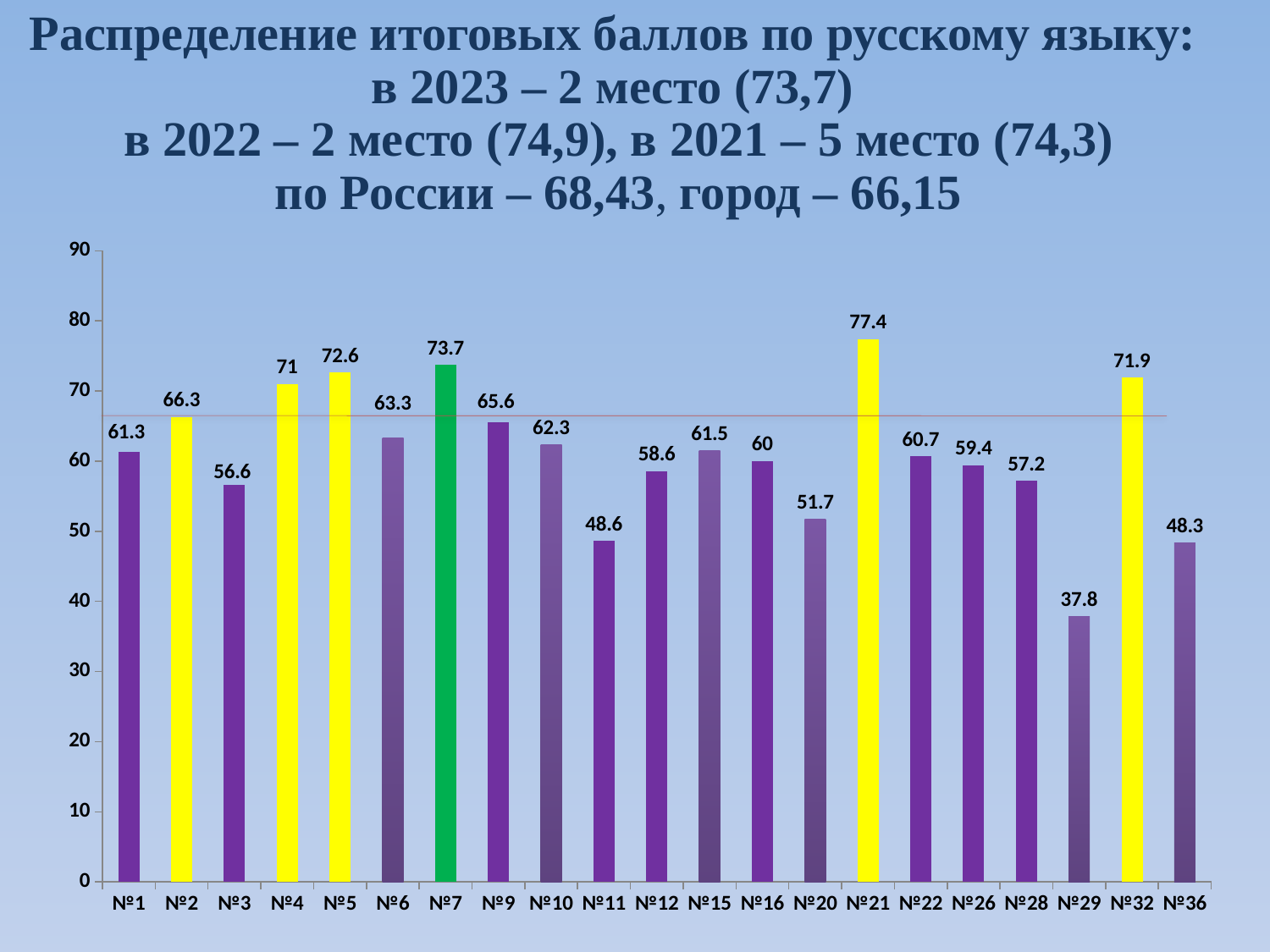
What is the value for №7? 73.7 How many categories are shown on the x axis? 21 Which category has the lowest value? №29 Which category's bar is coloured green? №7 Which is larger, the value for №10 or the value for №11? №10 What is the difference between the values for №21 and №7? 3.7 What is the difference between the values for №4 and №3? 14.4 Is the value for №36 greater or less than 50? less What is the value for №16? 60 What is the value for №29? 37.8 What kind of chart is shown on the slide? bar chart Which category has the highest value? №21